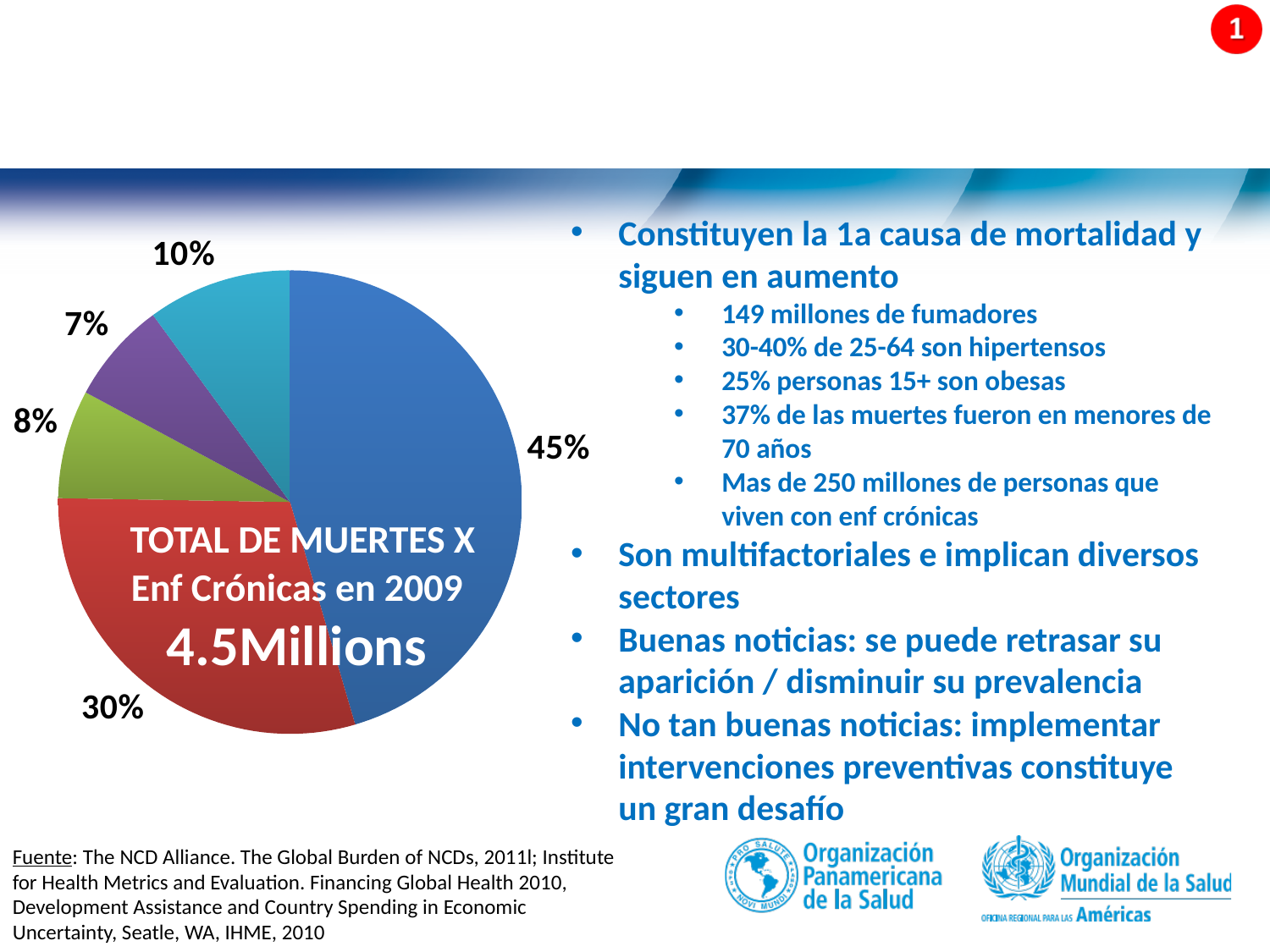
What percentage is labelled on the light blue (teal) slice of the pie chart? 10% What is the difference in percentage points between the blue slice (45%) and the red slice (30%)? 15 What kind of chart is shown on the slide? pie chart What percentage is labelled on the green slice of the pie chart? 8% What percentage is shown for the largest slice of the pie chart? 45% What is the combined share of the green (8%) and purple (7%) slices? 15% Which slice is larger, the purple slice or the teal slice? the teal slice (10%) How many slices does the pie chart have? 5 What percentage is shown for the smallest slice of the pie chart? 7% What year does the pie chart title refer to? 2009 What total number of deaths is stated in the centre of the pie chart? 4.5Millions What percentage is labelled on the red slice of the pie chart? 30%